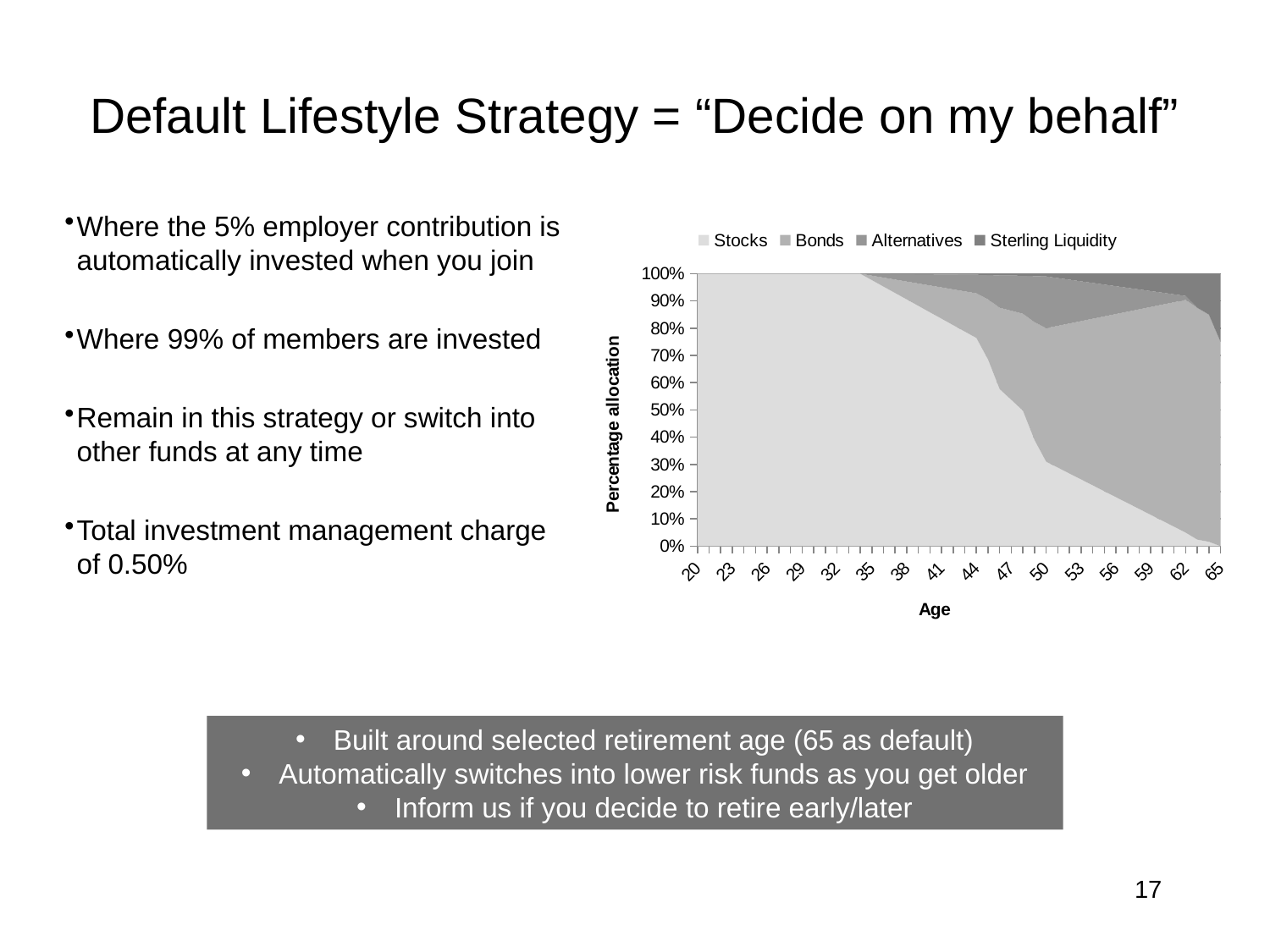
Which series are listed in the chart legend? Stocks, Bonds, Alternatives, Sterling Liquidity Which series has the largest allocation at age 65? Bonds What is the title of the chart's vertical axis? Percentage allocation How many age labels are shown on the x axis? 16 Is the allocation to Bonds at age 65 greater or less than 50%? greater How many series does the chart legend list? 4 What kind of chart is shown on the slide? Stacked area chart Is the allocation to Stocks at age 38 greater or less than 80%? greater What is the allocation to Stocks at age 20? 100% Is the allocation to Stocks at age 50 greater or less than 50%? less What is the allocation to Stocks at age 65? 0% Does the allocation to Stocks rise or fall as age increases along the x axis? Fall